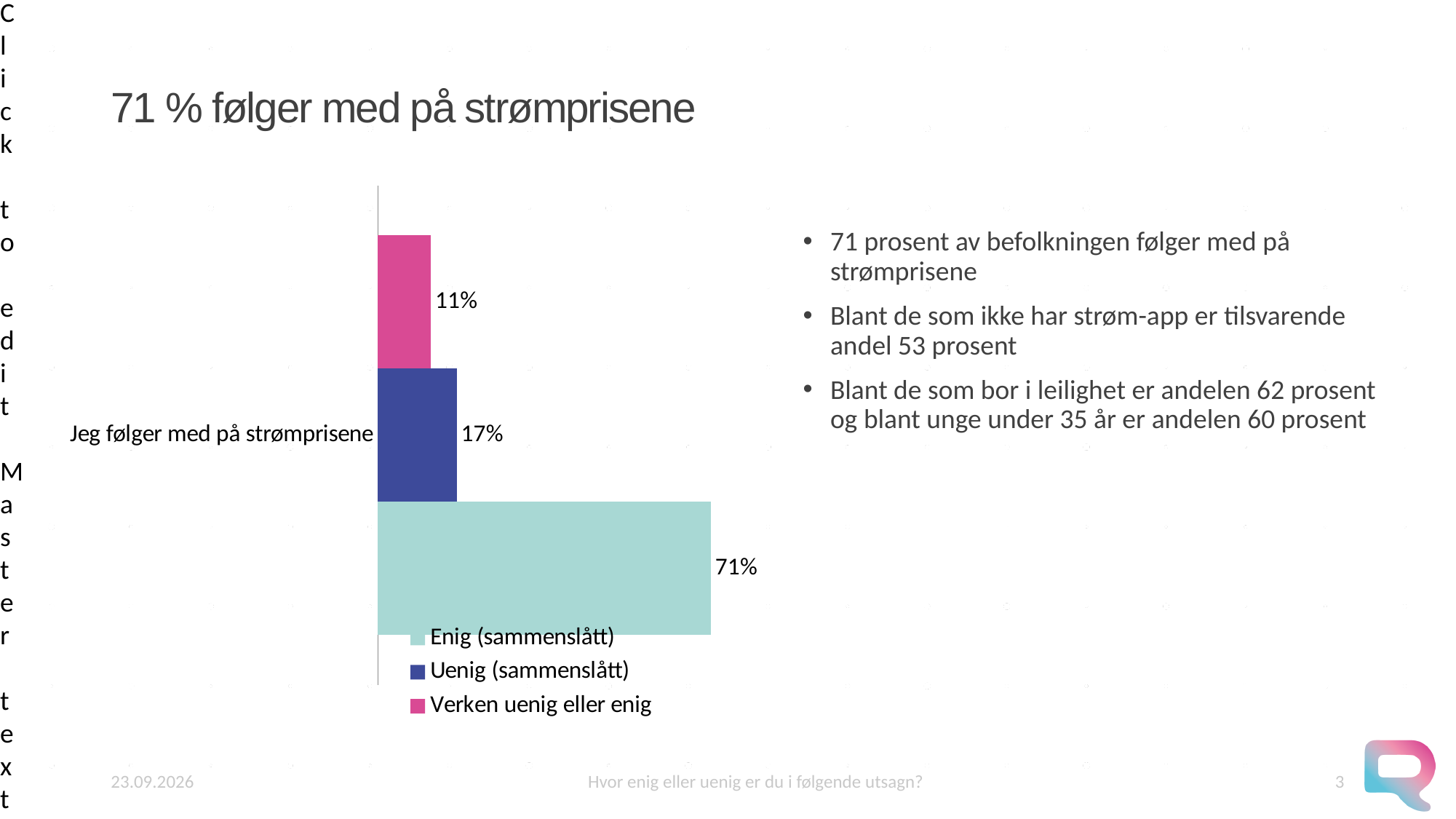
What is the value for Verken uenig eller enig for "Jeg følger med på strømprisene"? 11% What is the value for Enig (sammenslått) for "Jeg følger med på strømprisene"? 71% What is the category label shown on the chart? Jeg følger med på strømprisene What is the difference between the Enig (sammenslått) value and the Uenig (sammenslått) value? 54% Which series has the highest value in the chart? Enig (sammenslått) What is the value for Uenig (sammenslått) for "Jeg følger med på strømprisene"? 17% Which series has the lowest value in the chart? Verken uenig eller enig Which is larger, the value for Uenig (sammenslått) or the value for Verken uenig eller enig? Uenig (sammenslått) How many categories are shown on the chart's category axis? 1 How many series does the legend list? 3 What is the difference between the Uenig (sammenslått) value and the Verken uenig eller enig value? 6% What kind of chart is shown on the slide? Bar chart